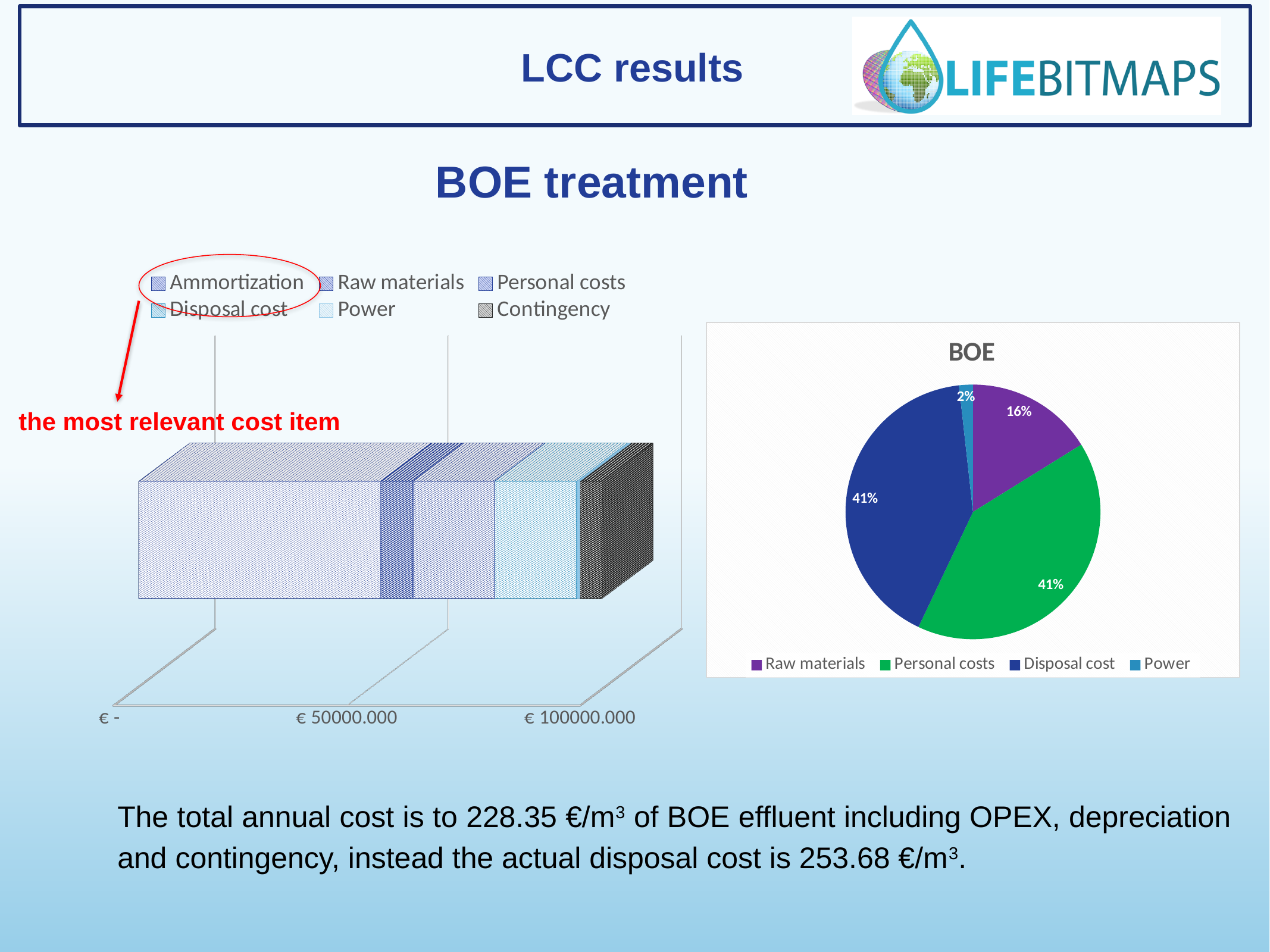
In the pie chart on the right, what share is shown for Raw materials? 16% How many categories does the legend of the pie chart on the right list? 4 In the pie chart on the right, which category has the smallest slice? Power What kind of chart is the chart on the left? Bar chart In the pie chart on the right, what share is shown for Personal costs? 41% What kind of chart is the chart on the right? Pie chart In the pie chart on the right, what share is shown for Power? 2% How many series does the legend of the chart on the left list? 6 What is the title of the pie chart on the right? BOE In the pie chart on the right, what is the difference in percentage points between Personal costs and Raw materials? 25% In the stacked bar chart on the left, which series occupies the largest segment of the bar? Ammortization In the pie chart on the right, which is larger: Raw materials or Power? Raw materials